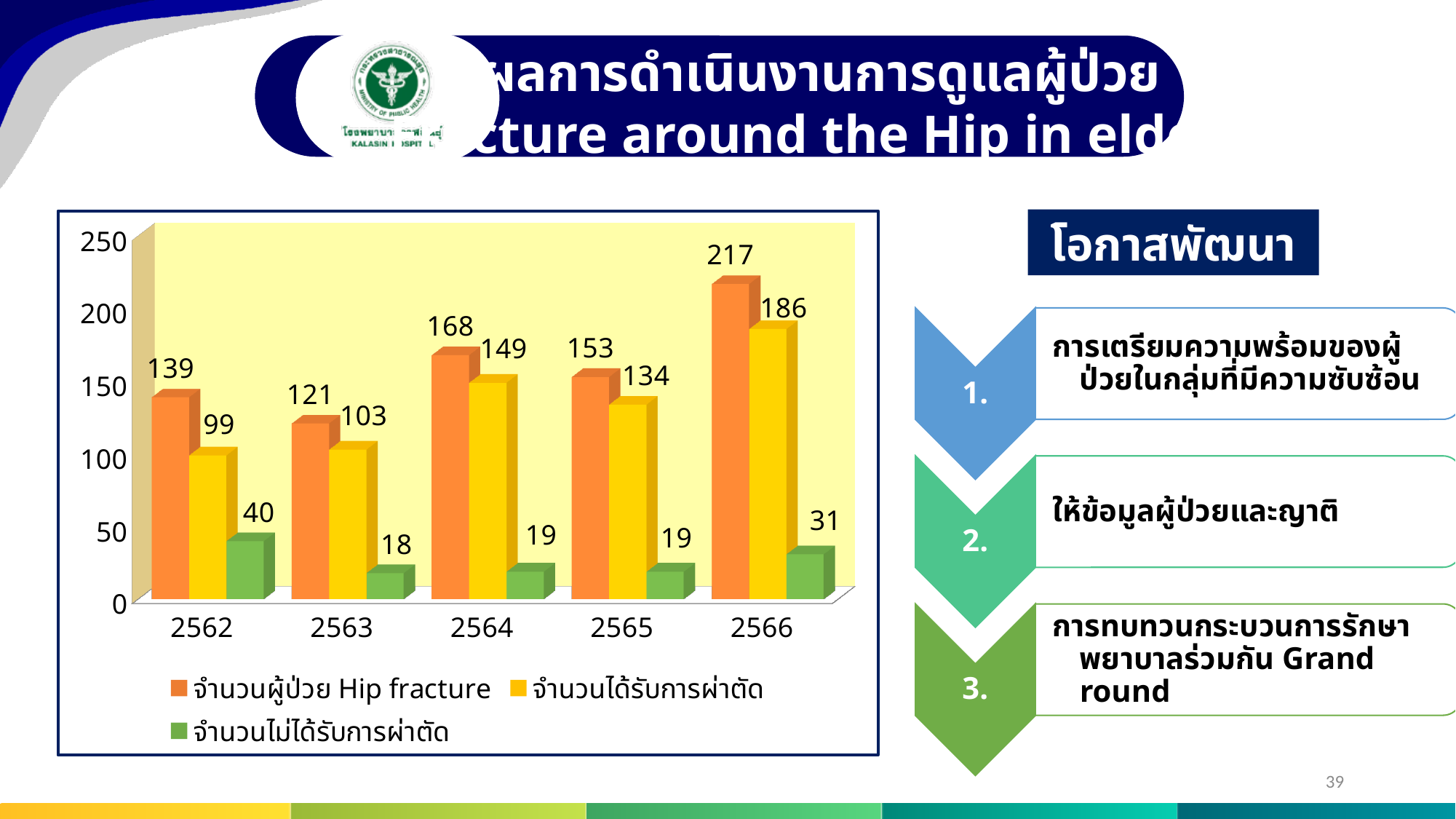
What is the value for จำนวนผู้ป่วย Hip fracture in 2566? 217 Which is larger: จำนวนได้รับการผ่าตัด in 2565 or in 2566? 2566 Which colour represents จำนวนได้รับการผ่าตัด in the chart? yellow What kind of chart is shown on the slide? bar chart In which year is จำนวนผู้ป่วย Hip fracture the highest? 2566 How many years are shown on the x axis of the chart? 5 Is the value for จำนวนผู้ป่วย Hip fracture in 2563 greater or less than 150? less How many series does the legend list? 3 What is the value for จำนวนได้รับการผ่าตัด in 2563? 103 What is the difference between จำนวนผู้ป่วย Hip fracture and จำนวนได้รับการผ่าตัด in 2564? 19 In which year is จำนวนไม่ได้รับการผ่าตัด the lowest? 2563 What is the value for จำนวนไม่ได้รับการผ่าตัด in 2562? 40